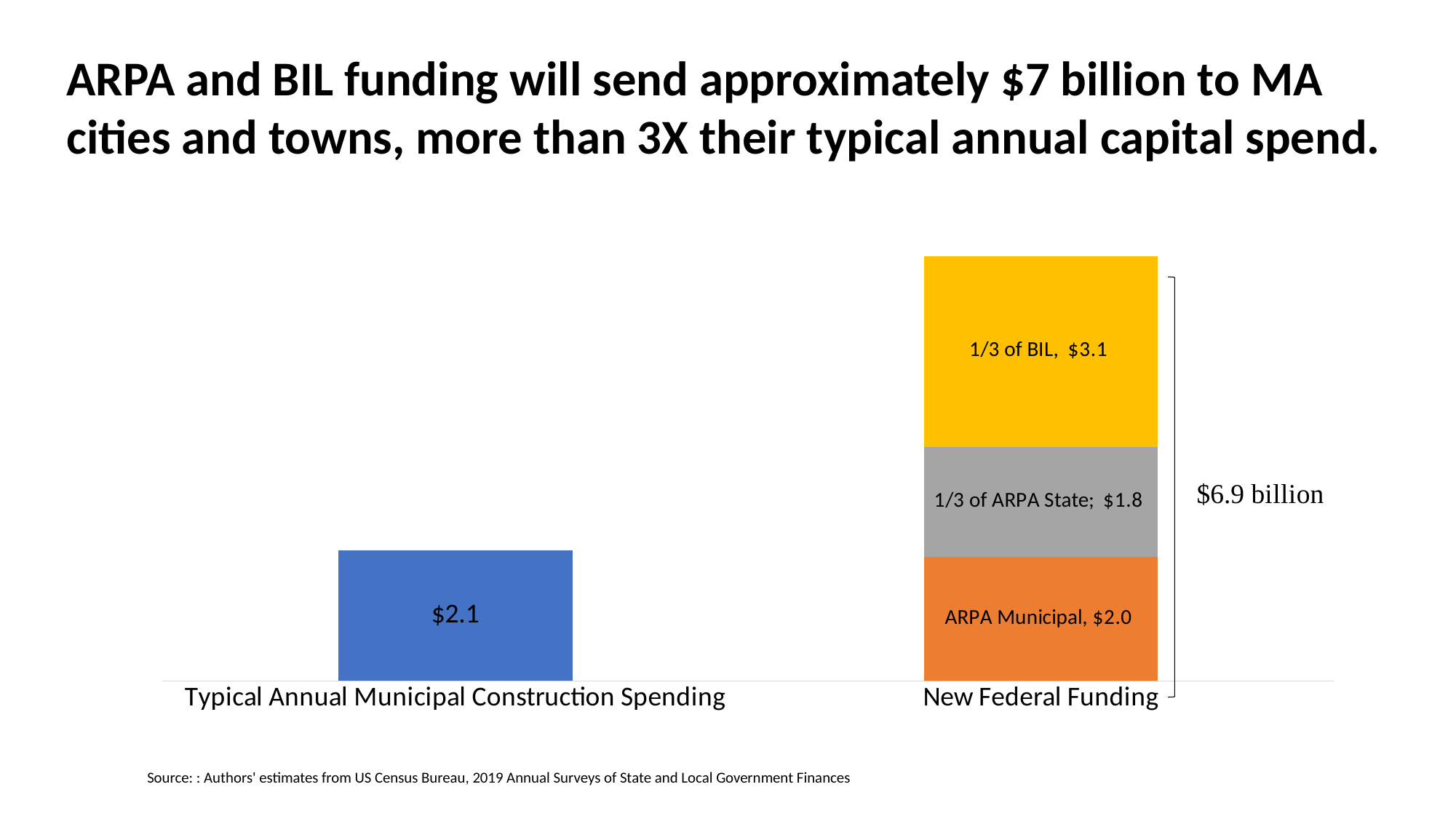
Which segment of the New Federal Funding bar is the smallest? 1/3 of ARPA State What type of chart is shown on the slide? Stacked bar chart What is the value shown for Typical Annual Municipal Construction Spending? $2.1 What is the total of the New Federal Funding stacked bar? $6.9 billion What is the value of the ARPA Municipal segment in the New Federal Funding bar? $2.0 Which is larger: the 1/3 of BIL segment or the ARPA Municipal segment? 1/3 of BIL Which segment of the New Federal Funding bar is the largest? 1/3 of BIL How many categories are shown on the x axis of the chart? 2 Which category has the taller bar? New Federal Funding What is the value of the 1/3 of BIL segment in the New Federal Funding bar? $3.1 What is the value of the 1/3 of ARPA State segment in the New Federal Funding bar? $1.8 What is the difference between the New Federal Funding total and Typical Annual Municipal Construction Spending? $4.8 billion